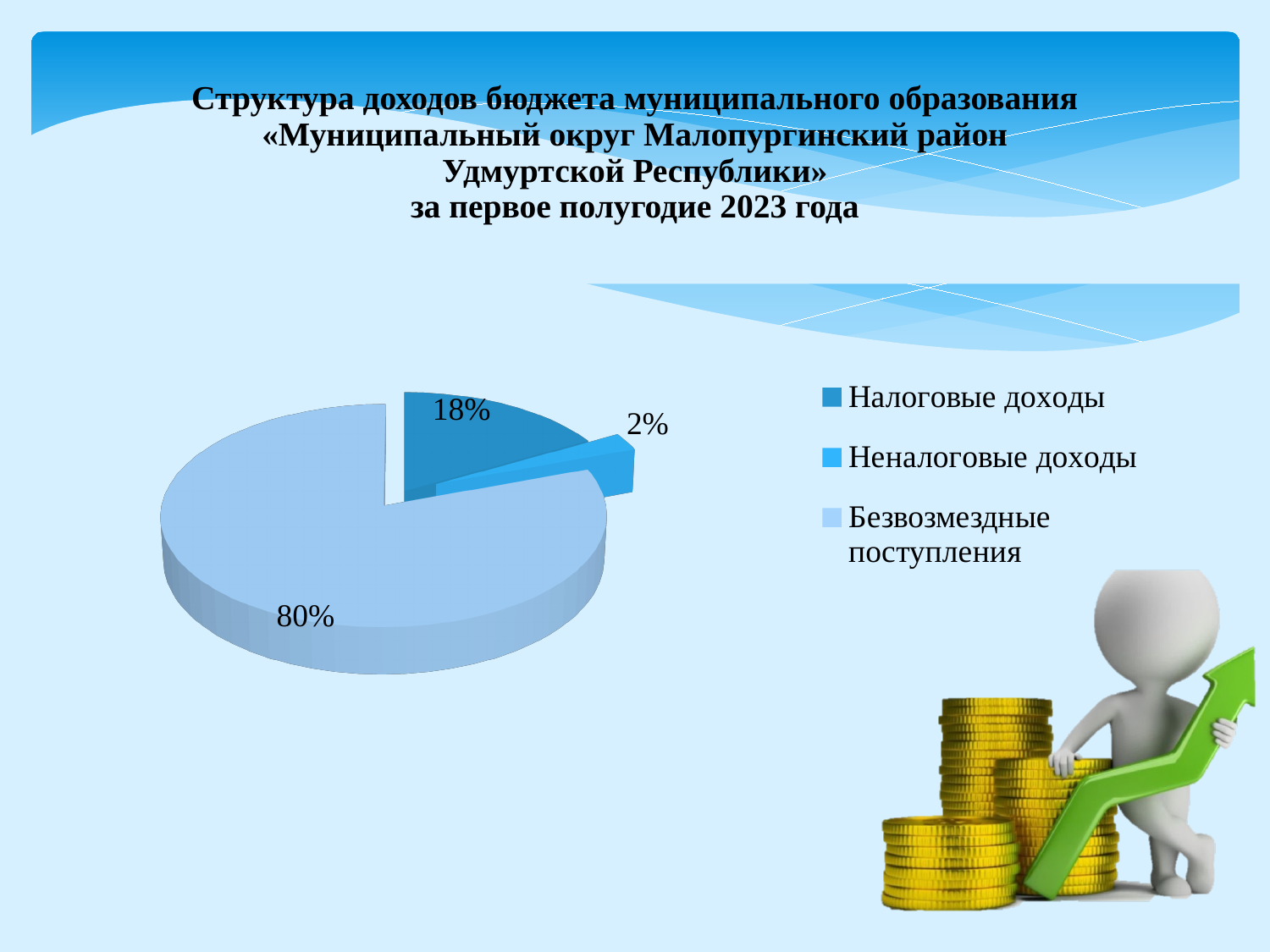
What share of the pie does Налоговые доходы represent? 18% What share of the pie does Неналоговые доходы represent? 2% What is the difference in percentage points between Налоговые доходы and Неналоговые доходы? 16 What is the difference in percentage points between Безвозмездные поступления and Налоговые доходы? 62 How many categories does the pie chart have? 3 What share of the pie does Безвозмездные поступления represent? 80% Which category has the smallest share of the pie? Неналоговые доходы How many entries does the legend list? 3 Which is larger, the share for Налоговые доходы or the share for Неналоговые доходы? Налоговые доходы Which category has the largest share of the pie? Безвозмездные поступления Which period does the chart title say the budget income structure covers? за первое полугодие 2023 года What kind of chart is shown on the slide? pie chart